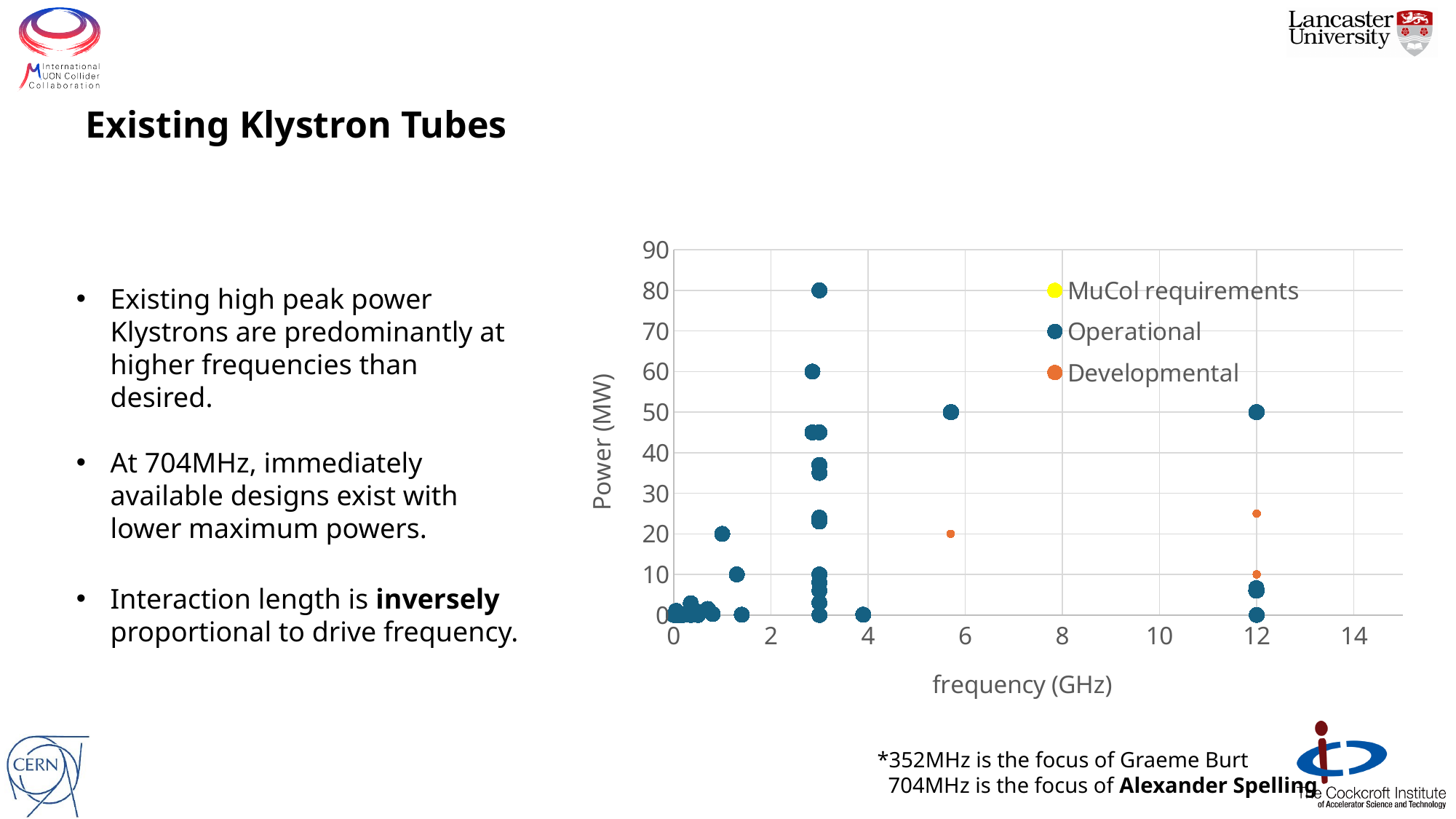
Is the Operational point near 1 GHz greater or less than 30 MW? less Is the Developmental point near 6 GHz greater or less than 30 MW? less What kind of chart is shown on the slide? scatter chart How many series does the chart legend list? 3 What is the label of the chart's x axis? frequency (GHz) Is the highest Operational point on the chart greater or less than 70 MW? greater Which series contains the point with the highest power on the chart? Operational What are the three series named in the chart legend? MuCol requirements, Operational, Developmental Near 6 GHz, which series has the higher power point, Operational or Developmental? Operational